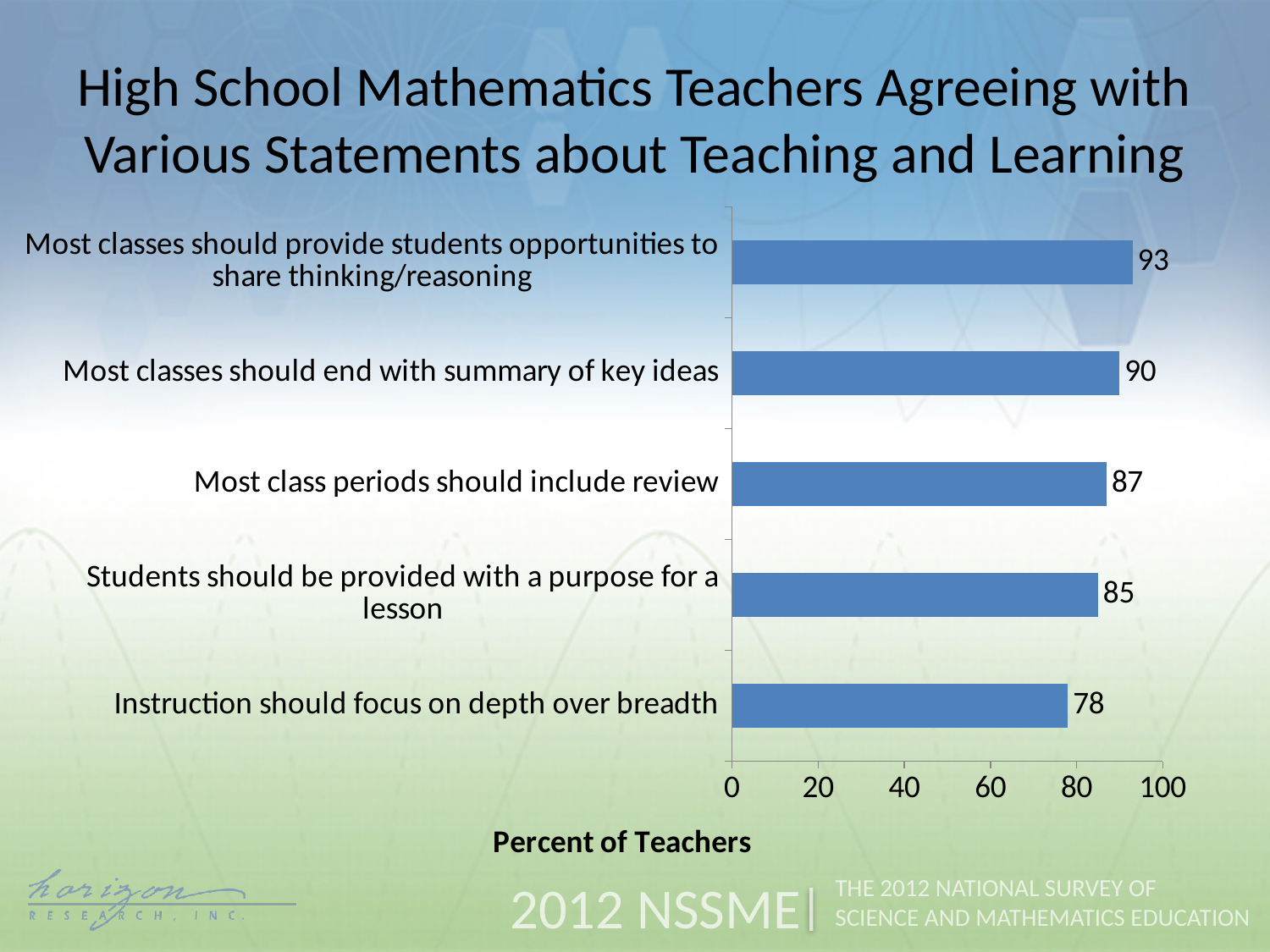
What kind of chart is shown on the slide? Bar chart What is the difference between the values for 'Most classes should end with summary of key ideas' and 'Students should be provided with a purpose for a lesson'? 5 What is the label of the horizontal axis? Percent of Teachers Is the value for 'Instruction should focus on depth over breadth' greater or less than 80? less Which statement has the lowest percent of teachers agreeing? Instruction should focus on depth over breadth Which has a larger value: 'Most class periods should include review' or 'Instruction should focus on depth over breadth'? Most class periods should include review What percent of teachers agree that instruction should focus on depth over breadth? 78 What is the value for 'Most class periods should include review'? 87 What percent of teachers agree that most classes should provide students opportunities to share thinking/reasoning? 93 How many statements are shown in the chart? 5 What is the difference between the highest and lowest values in the chart? 15 Which statement has the highest percent of teachers agreeing? Most classes should provide students opportunities to share thinking/reasoning